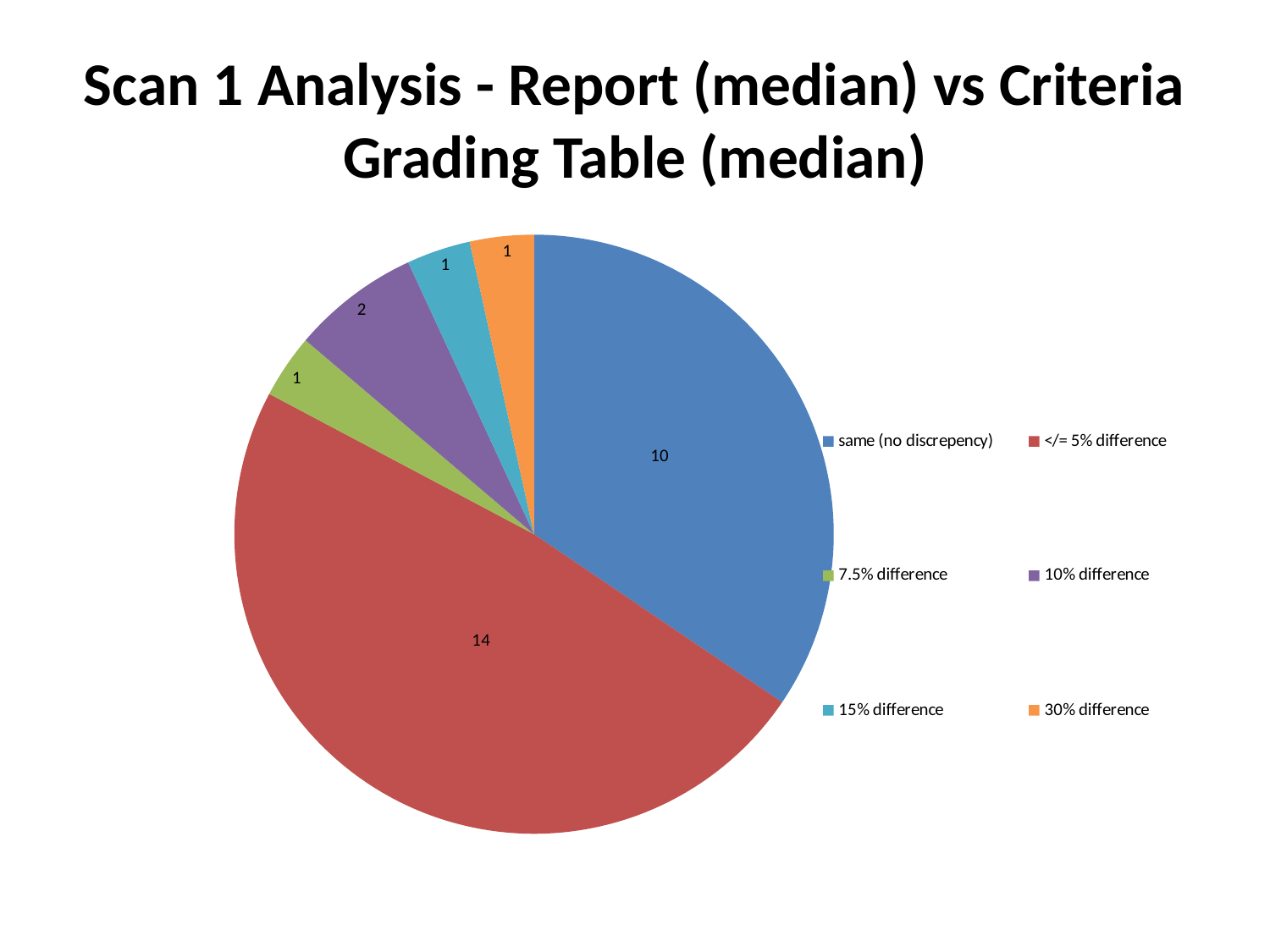
What is the value for the "10% difference" slice? 2 What is the difference between the "</= 5% difference" value and the "same (no discrepency)" value? 4 What is the value for the "7.5% difference" slice? 1 Which is larger, the "10% difference" slice or the "15% difference" slice? 10% difference How many categories does the pie chart have? 6 Which category has the largest slice of the pie? </= 5% difference What is the total of all the slice values in the pie chart? 29 What type of chart is shown on the slide? pie chart What colour is the "30% difference" slice? orange What is the value for the "same (no discrepency)" slice? 10 What is the value for the "</= 5% difference" slice? 14